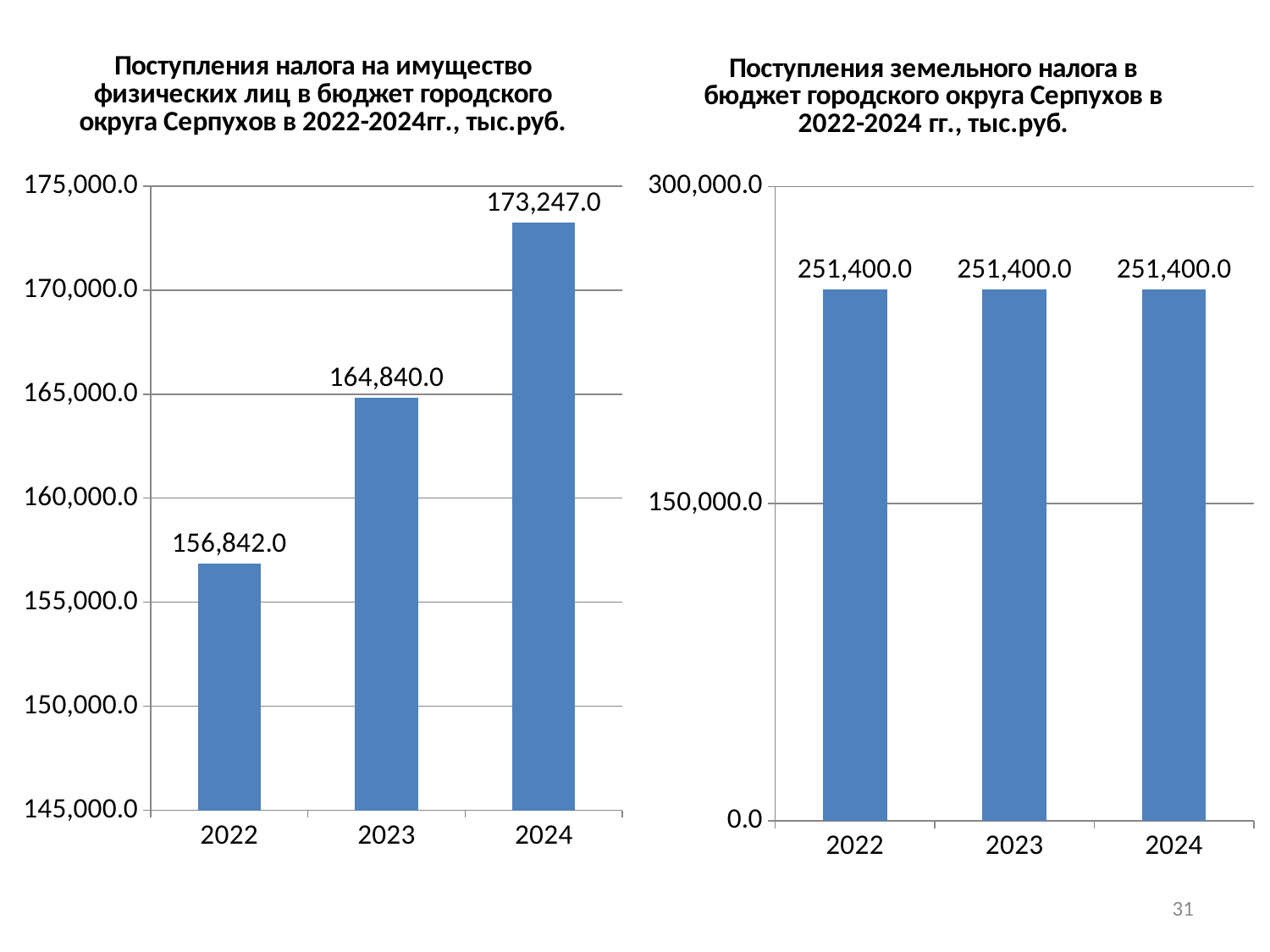
What kind of chart is the left chart (property tax receipts)? bar chart In the left chart (property tax receipts), what is the difference between the 2024 and 2023 values? 8,407.0 In the left chart (property tax receipts), which year has the lowest value? 2022 In the right chart (land tax receipts), is the value for 2022 greater or less than 150,000.0? greater How many bars are shown in the right chart (land tax receipts)? 3 In the right chart (land tax receipts), what is the value for 2023? 251,400.0 In the left chart (property tax receipts), what is the difference between the 2023 and 2022 values? 7,998.0 In the left chart (property tax receipts), which year has the highest value? 2024 In the left chart (property tax receipts), what is the value for 2022? 156,842.0 In the left chart (property tax receipts), what is the value for 2024? 173,247.0 In the left chart (property tax receipts), which is larger, the value for 2023 or the value for 2022? 2023 In the left chart (property tax receipts), do the values rise or fall from 2022 to 2024? rise